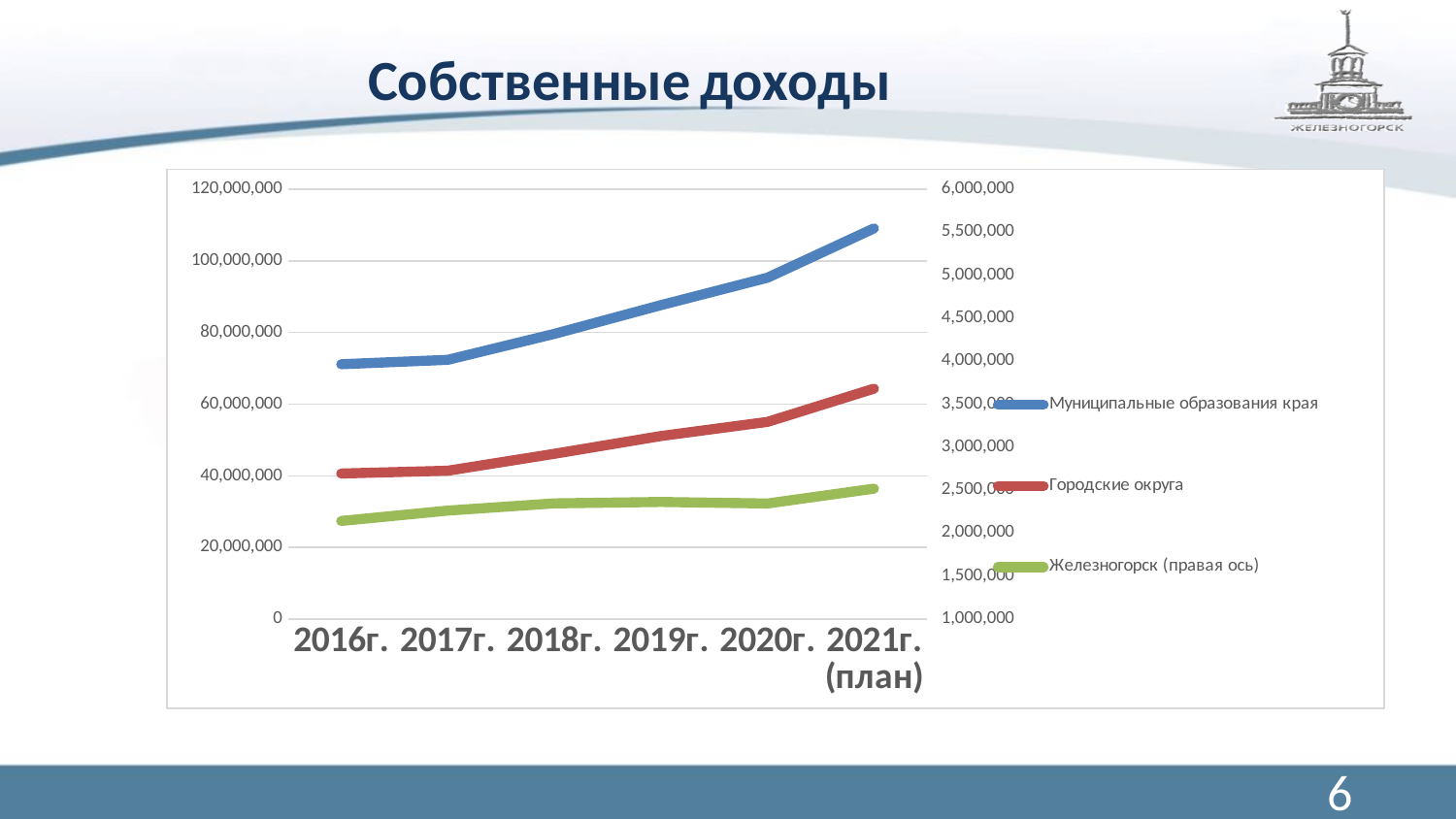
Which series is plotted on the right axis according to the legend? Железногорск (правая ось) Is the value for Муниципальные образования края in 2021г. (план) greater or less than 100,000,000? greater Is the value for Муниципальные образования края in 2016г. greater or less than 60,000,000? greater How many years are shown along the x axis? 6 How many series does the legend list? 3 What kind of chart is shown on the slide? line chart What is the title of the chart? Собственные доходы Does the value for Муниципальные образования края rise or fall from 2016г. to 2021г. (план)? rise Is the value for Городские округа in 2016г. greater or less than 60,000,000? less Which series is higher on the left axis in 2019г., Муниципальные образования края or Городские округа? Муниципальные образования края In which year is the value for Муниципальные образования края highest? 2021г. (план) Does the value for Городские округа rise or fall from 2016г. to 2021г. (план)? rise